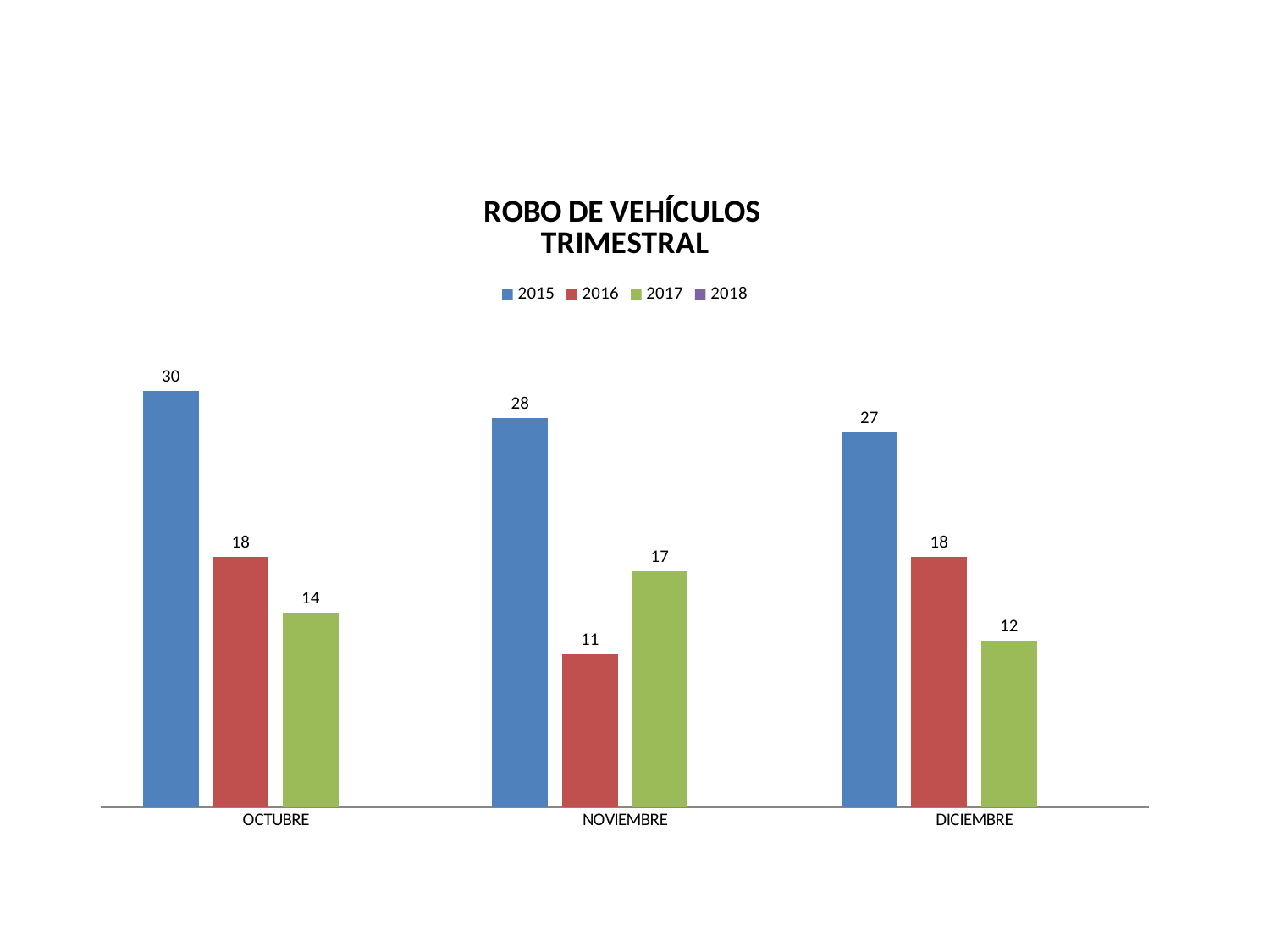
What is the value for 2017 in DICIEMBRE? 12 Which is larger in NOVIEMBRE, the value for 2016 or the value for 2017? 2017 What is the difference between the 2015 and 2016 values in OCTUBRE? 12 Do the values for 2015 rise or fall from OCTUBRE to DICIEMBRE? Fall Which month has the lowest value for 2016? NOVIEMBRE How many series does the legend list? 4 What is the title of the chart? ROBO DE VEHÍCULOS TRIMESTRAL How many months are shown on the x axis? 3 What is the value for 2015 in OCTUBRE? 30 Which month has the highest value for 2015? OCTUBRE What is the value for 2016 in NOVIEMBRE? 11 What kind of chart is shown on the slide? Bar chart